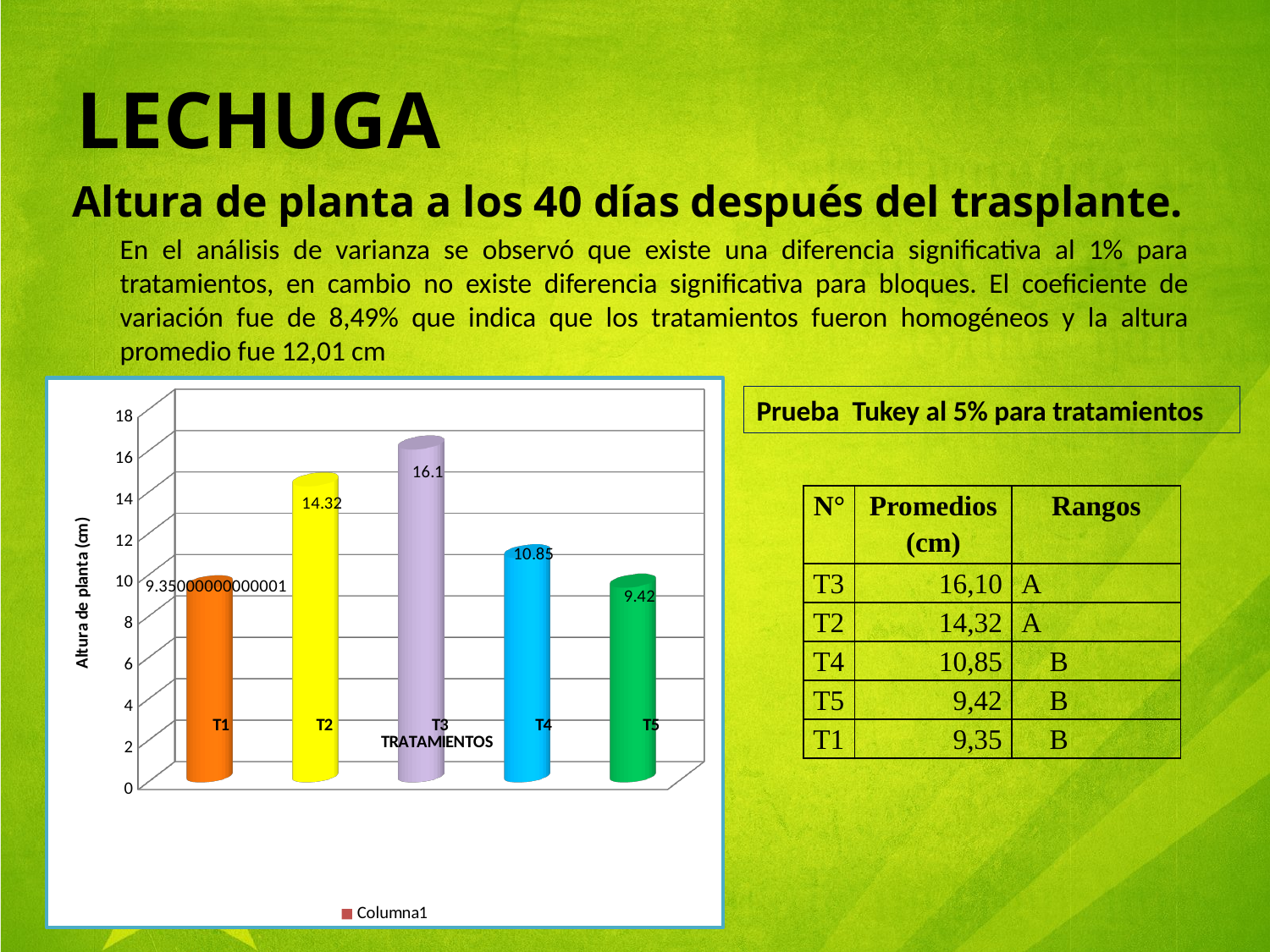
What is the value for T2 in the bar chart? 14.32 What is the difference between the values for T3 and T2 in the bar chart? 1.78 What kind of chart is shown on the slide? bar chart Is the value for T5 in the bar chart greater or less than 10? less What is the value for T5 in the bar chart? 9.42 Which treatment has the highest plant height in the bar chart? T3 What is the value for T4 in the bar chart? 10.85 How many treatments are shown in the bar chart? 5 What is the value for T3 in the bar chart? 16.1 Which is larger in the bar chart, the value for T2 or the value for T4? T2 What is the difference between the values for T2 and T4 in the bar chart? 3.47 What is the title of the vertical axis of the bar chart? Altura de planta (cm)